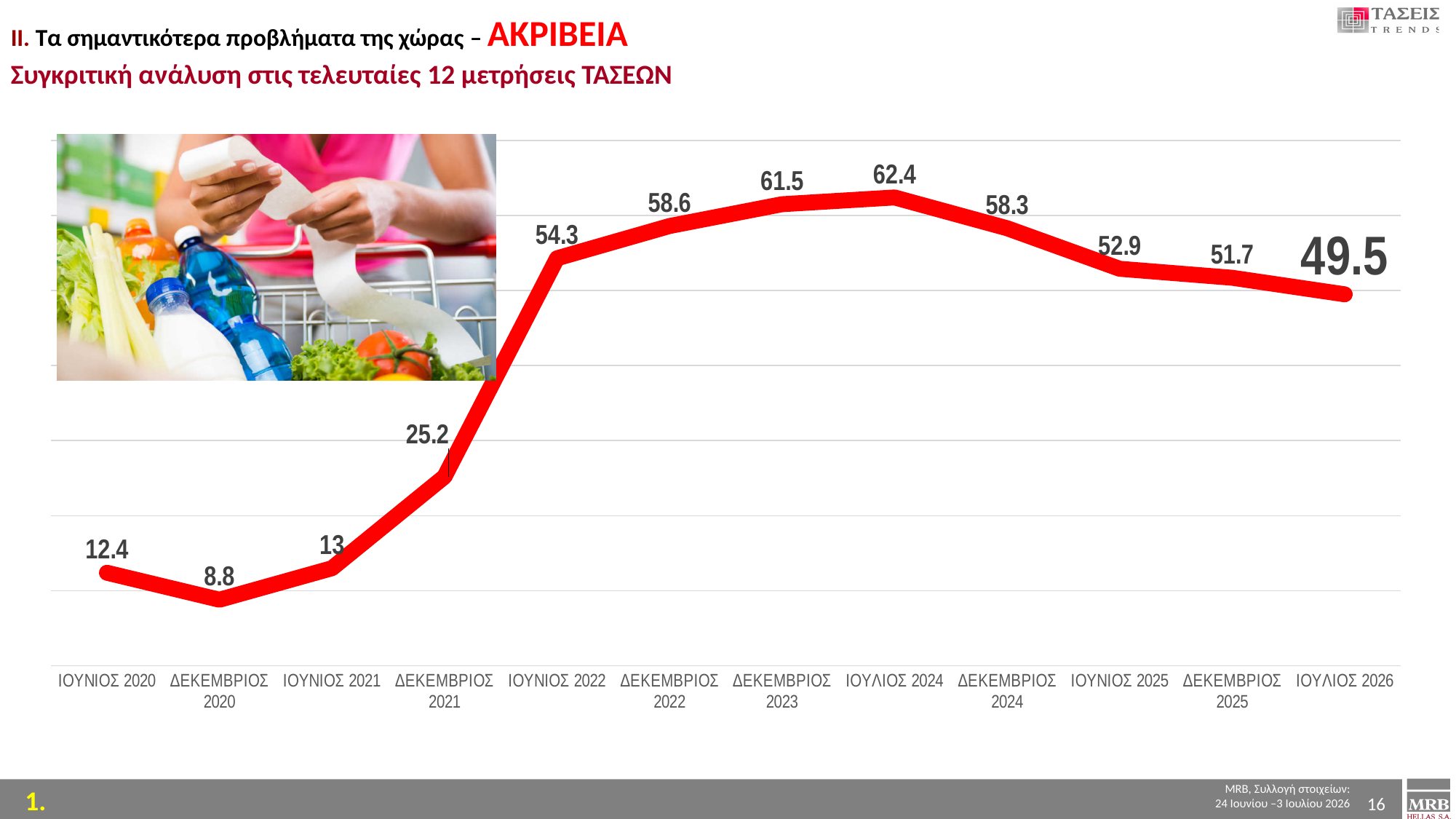
Which measurement has the lowest value? ΔΕΚΕΜΒΡΙΟΣ 2020 Which is larger, the value for ΔΕΚΕΜΒΡΙΟΣ 2022 or the value for ΔΕΚΕΜΒΡΙΟΣ 2024? ΔΕΚΕΜΒΡΙΟΣ 2022 What colour is the line on the chart? Red What is the value for ΙΟΥΛΙΟΣ 2026? 49.5 Do the values rise or fall from ΙΟΥΛΙΟΣ 2024 to ΙΟΥΛΙΟΣ 2026? Fall What is the value for ΙΟΥΝΙΟΣ 2022? 54.3 What is the value for ΔΕΚΕΜΒΡΙΟΣ 2021? 25.2 How many measurements are plotted on the chart? 12 What is the difference between the values for ΙΟΥΛΙΟΣ 2024 and ΙΟΥΛΙΟΣ 2026? 12.9 What is the difference between the values for ΙΟΥΝΙΟΣ 2022 and ΔΕΚΕΜΒΡΙΟΣ 2021? 29.1 Which measurement has the highest value? ΙΟΥΛΙΟΣ 2024 What kind of chart is shown on the slide? Line chart